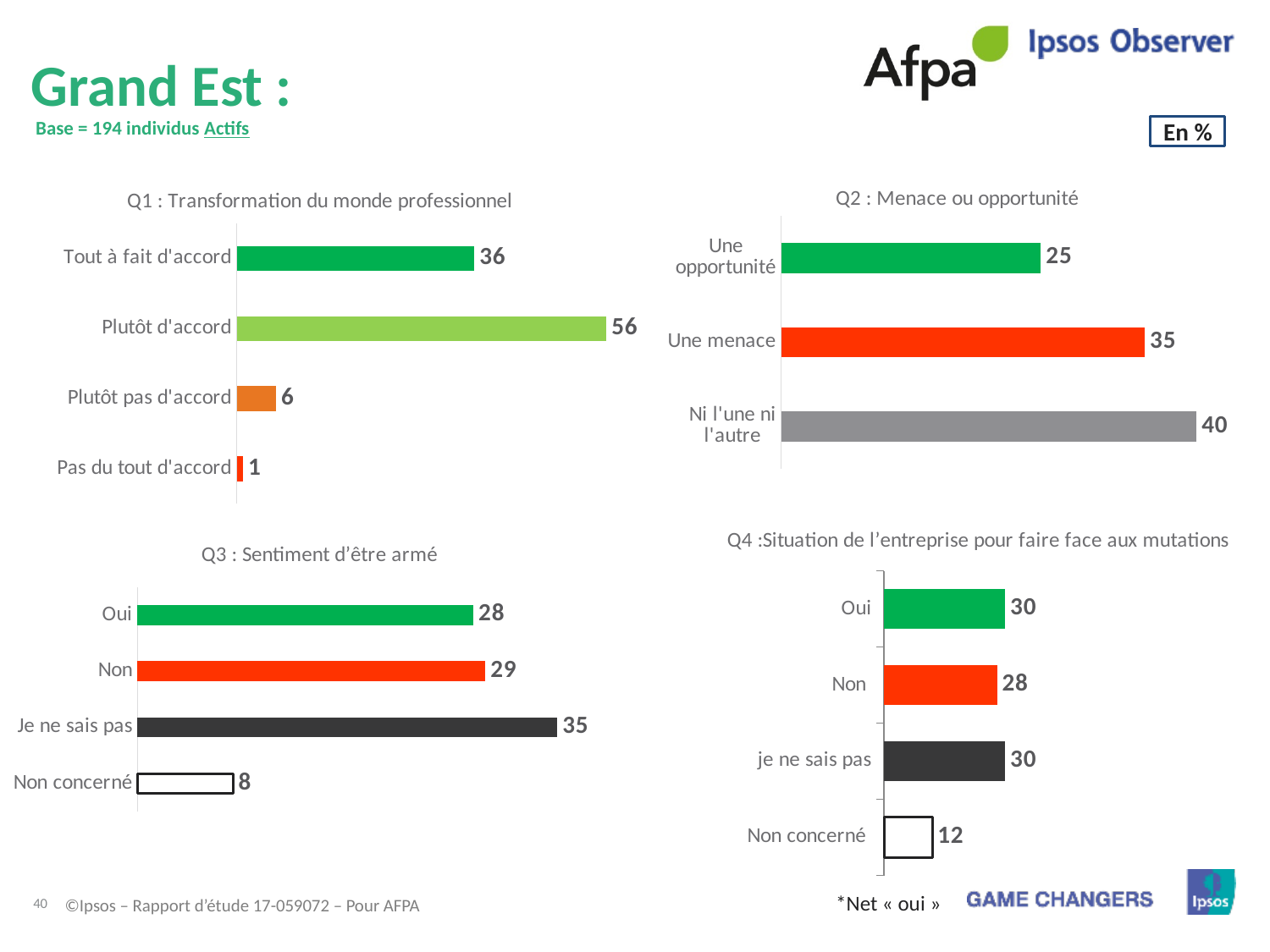
What kind of chart is the Q1 : Transformation du monde professionnel chart? Bar chart In the Q2 : Menace ou opportunité chart, what is the value for Une menace? 35 In the Q2 : Menace ou opportunité chart, how many categories are shown? 3 In the Q1 : Transformation du monde professionnel chart, what is the difference between Plutôt d'accord and Tout à fait d'accord? 20 In the Q1 : Transformation du monde professionnel chart, which category has the lowest value? Pas du tout d'accord In the Q2 : Menace ou opportunité chart, which category has the highest value? Ni l'une ni l'autre In the Q3 : Sentiment d'être armé chart, what is the value for Non concerné? 8 In the Q3 : Sentiment d'être armé chart, what is the difference between Je ne sais pas and Oui? 7 In the Q3 : Sentiment d'être armé chart, which is larger, Oui or Non? Non In the Q4 : Situation de l'entreprise pour faire face aux mutations chart, what is the value for Non concerné? 12 In the Q4 : Situation de l'entreprise pour faire face aux mutations chart, how many categories are shown? 4 In the Q1 : Transformation du monde professionnel chart, what is the value for Plutôt d'accord? 56